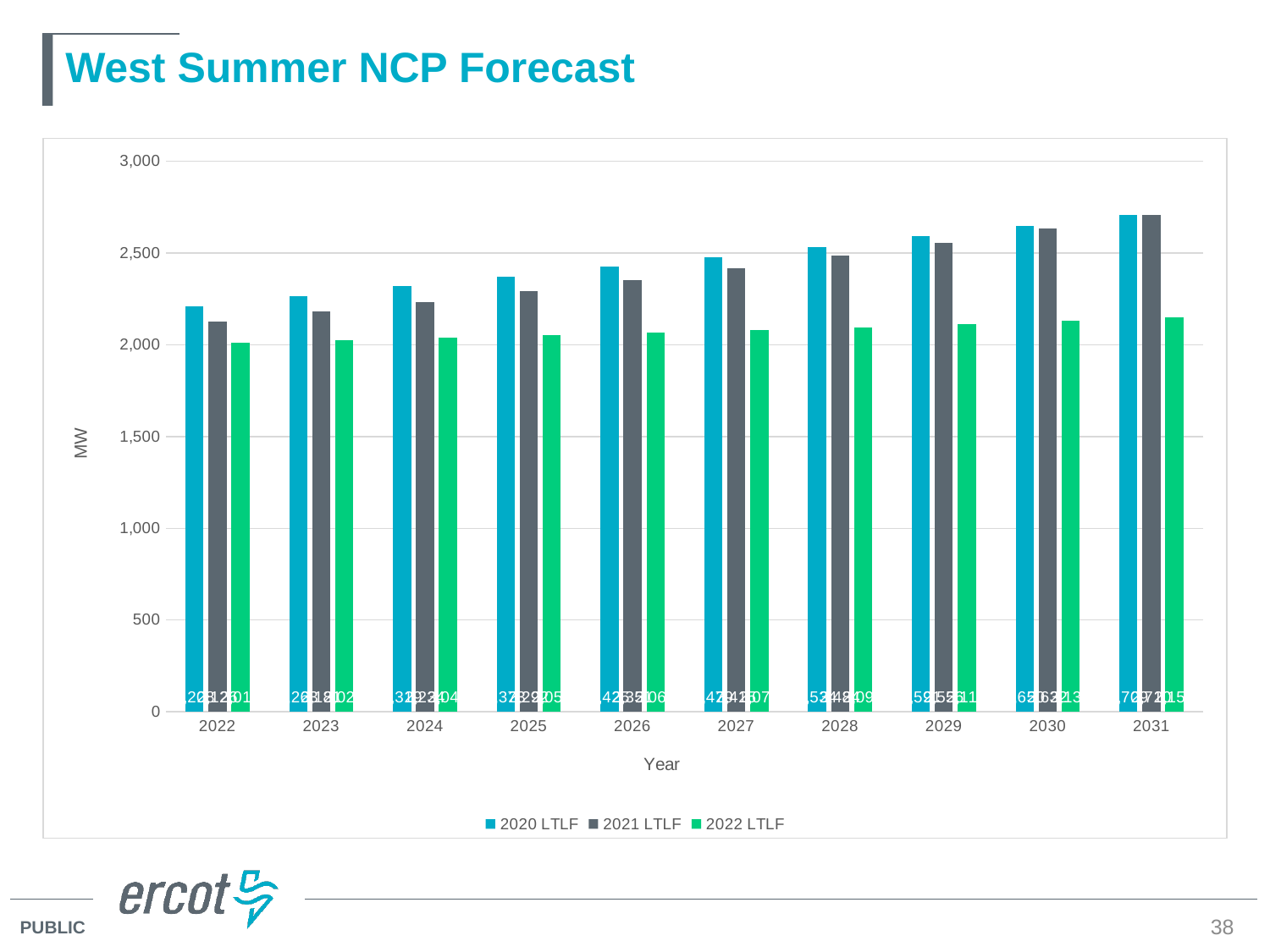
Is the 2020 LTLF value for 2031 greater or less than 2,500? greater Is the 2021 LTLF value for 2025 greater or less than 2,500? less What kind of chart is shown on the slide? bar chart In 2024, which is larger, the 2020 LTLF value or the 2021 LTLF value? 2020 LTLF What is the label of the y axis? MW How many years are shown on the x axis? 10 Do the 2020 LTLF values rise or fall from 2022 to 2031? rise Is the 2020 LTLF value for 2022 greater or less than 2,500? less In 2026, which is larger, the 2020 LTLF value or the 2022 LTLF value? 2020 LTLF How many series does the legend list? 3 What is the title of the chart? West Summer NCP Forecast